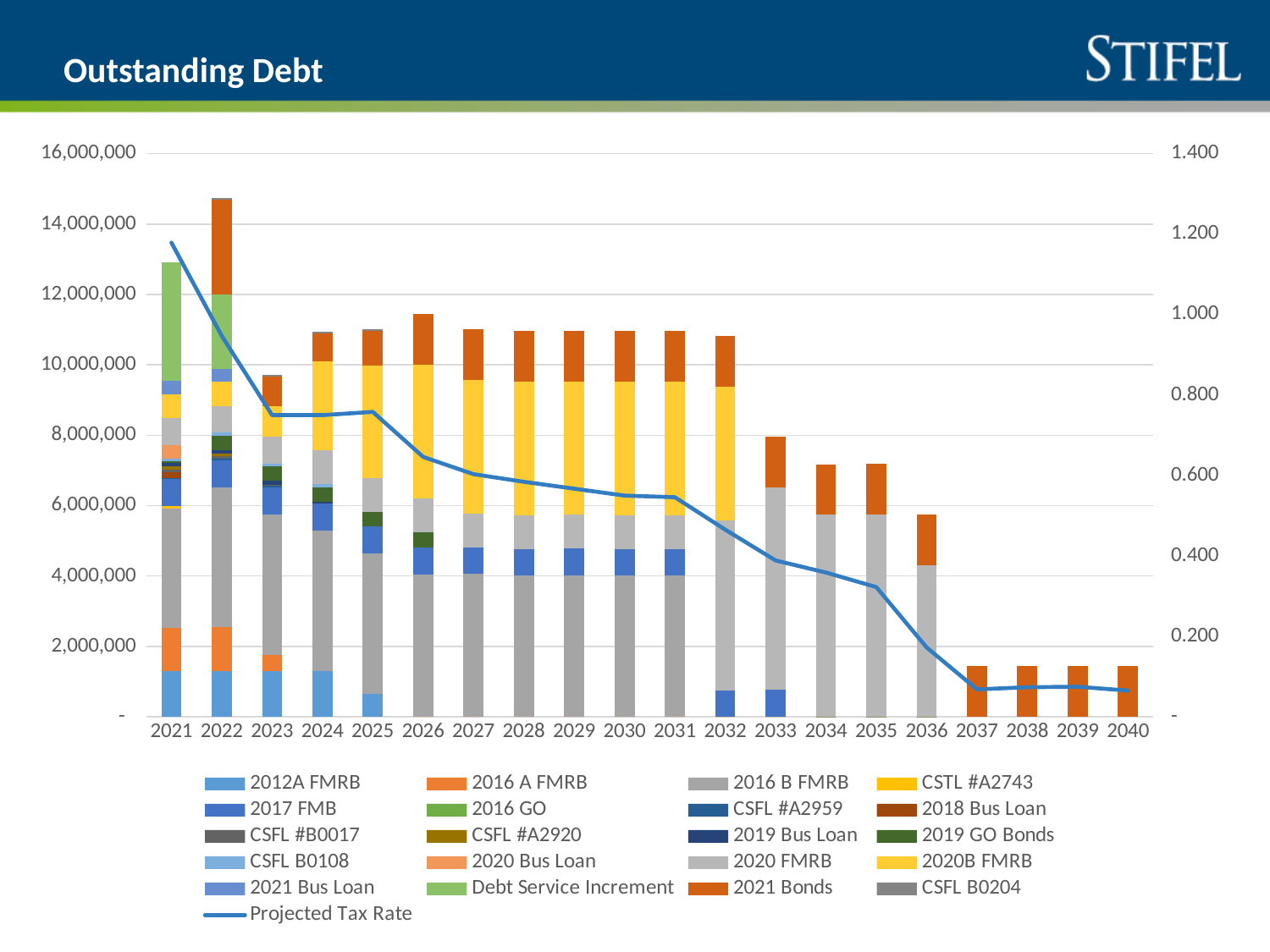
Does the Projected Tax Rate line generally rise or fall from 2021 to 2040? fall Is the total outstanding debt for 2023 greater or less than 10,000,000? less Is the total outstanding debt for 2034 greater or less than 6,000,000? greater Is the total outstanding debt for 2022 greater or less than 14,000,000? greater Which year has the larger total outstanding debt, 2021 or 2023? 2021 How many years are shown along the x axis? 20 What is the title of the slide? Outstanding Debt What kind of chart is shown on the slide? Stacked bar chart with a line Which year has the highest total outstanding debt? 2022 How many series does the legend list? 21